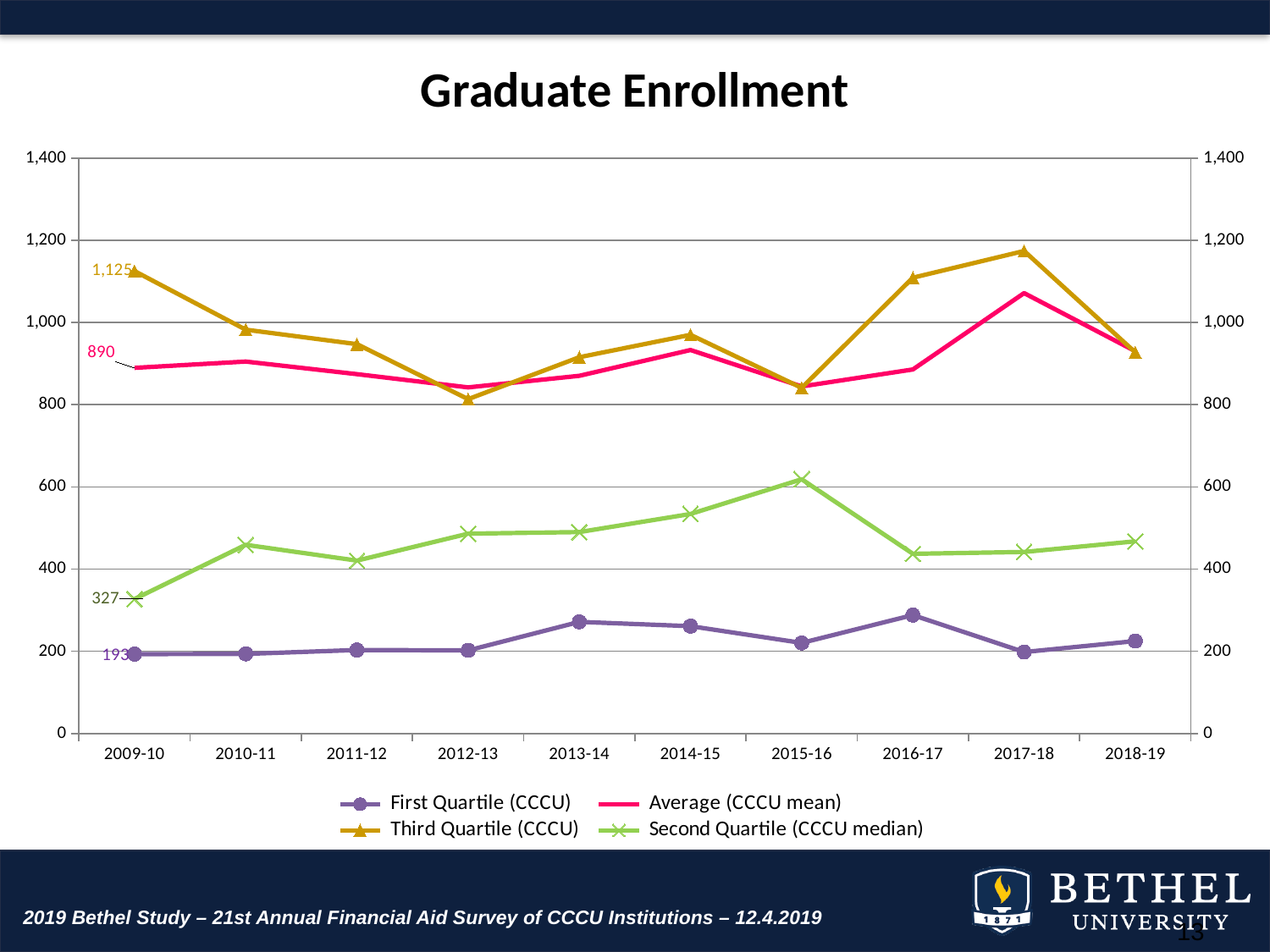
In which year does the Second Quartile (CCCU median) series reach its highest value? 2015-16 In 2009-10, how much higher is the Third Quartile (CCCU) value than the Average (CCCU mean) value? 235 What is the value of the Second Quartile (CCCU median) series for 2009-10? 327 How many series does the legend list? 4 Is the Average (CCCU mean) value for 2017-18 greater or less than 1,000? greater In 2016-17, which is larger: the Third Quartile (CCCU) value or the Average (CCCU mean) value? Third Quartile (CCCU) What is the value of the Third Quartile (CCCU) series for 2009-10? 1,125 In 2009-10, what is the difference between the Second Quartile (CCCU median) and First Quartile (CCCU) values? 134 What kind of chart is shown on the slide? Line chart How many academic years are plotted on the x axis? 10 What is the value of the First Quartile (CCCU) series for 2009-10? 193 What is the value of the Average (CCCU mean) series for 2009-10? 890